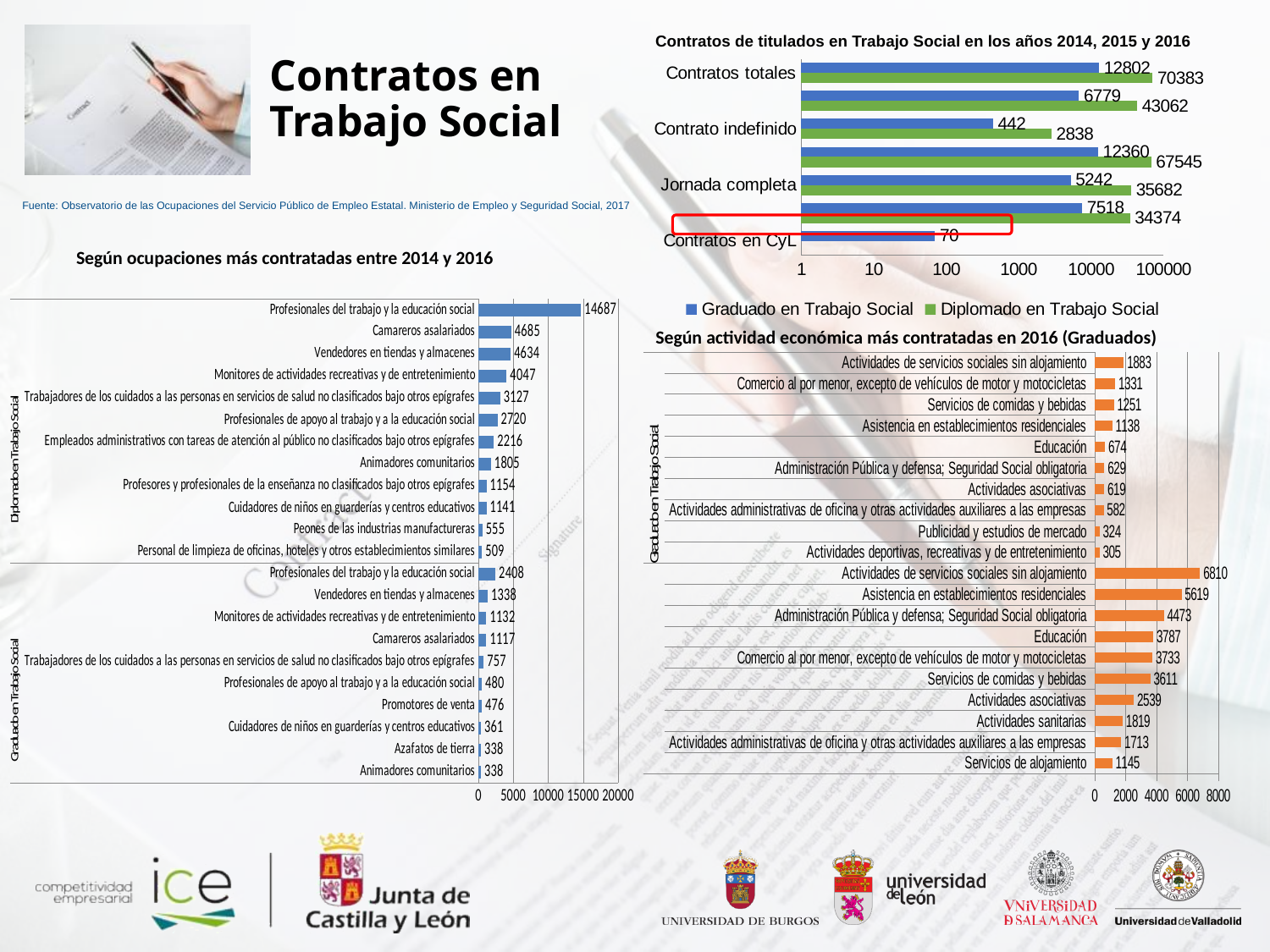
In the chart 'Según ocupaciones más contratadas entre 2014 y 2016', what is the value for 'Camareros asalariados' in the Diplomado en Trabajo Social group? 4685 What type of chart is 'Contratos de titulados en Trabajo Social en los años 2014, 2015 y 2016'? Bar chart In the chart 'Según ocupaciones más contratadas entre 2014 y 2016', what is the difference between 'Vendedores en tiendas y almacenes' (4634) and 'Camareros asalariados' (4685) in the Diplomado group? 51 In the chart 'Contratos de titulados en Trabajo Social en los años 2014, 2015 y 2016', how many series does the legend list? 2 In the chart 'Según ocupaciones más contratadas entre 2014 y 2016', how many occupations are listed in the Graduado en Trabajo Social group? 10 In the chart 'Según actividad económica más contratadas en 2016 (Graduados)', what is the difference between 'Asistencia en establecimientos residenciales' (5619) and 'Administración Pública y defensa; Seguridad Social obligatoria' (4473) in the orange series? 1146 In the chart 'Contratos de titulados en Trabajo Social en los años 2014, 2015 y 2016', what is the value for 'Contratos en CyL' for Graduado en Trabajo Social? 70 In the chart 'Según actividad económica más contratadas en 2016 (Graduados)', which is larger in the blue Graduado group: 'Educación' or 'Actividades asociativas'? Educación In the chart 'Según actividad económica más contratadas en 2016 (Graduados)', which activity has the lowest value in the orange series? Actividades deportivas, recreativas y de entretenimiento In the chart 'Según ocupaciones más contratadas entre 2014 y 2016', what is the value for 'Profesionales del trabajo y la educación social' in the Diplomado en Trabajo Social group? 14687 In the chart 'Según ocupaciones más contratadas entre 2014 y 2016', which occupation has the highest value in the Graduado en Trabajo Social group? Profesionales del trabajo y la educación social